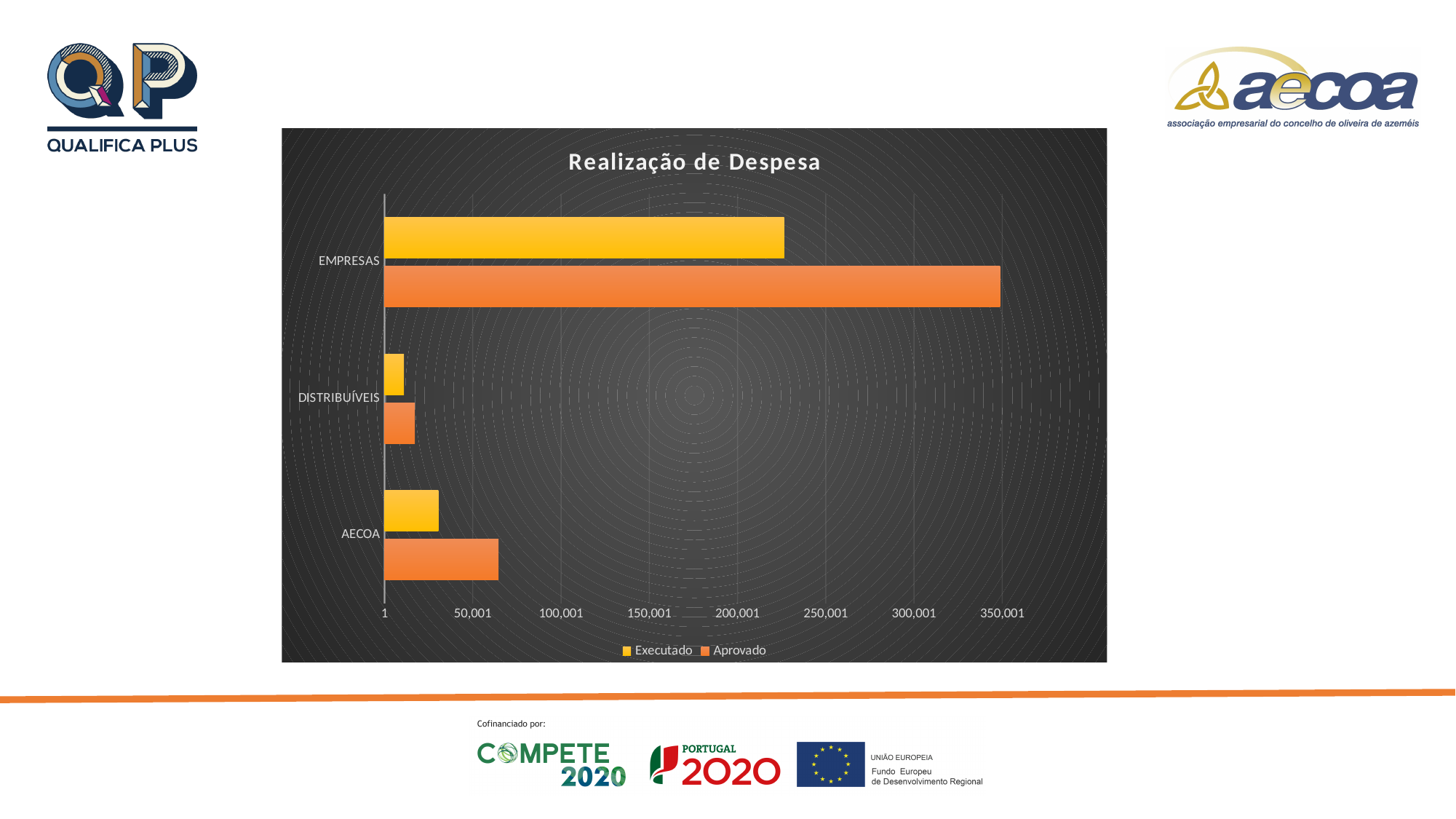
For EMPRESAS, which is larger: Executado or Aprovado? Aprovado How many categories are shown on the chart? 3 Which category has the highest Aprovado value? EMPRESAS Is the Aprovado value for EMPRESAS greater or less than 300,001? greater What type of chart is shown on the slide? bar chart Which category has the lowest Executado value? DISTRIBUÍVEIS Is the Executado value for AECOA greater or less than 50,001? less What is the title of the chart? Realização de Despesa Is the Aprovado value for AECOA greater or less than 50,001? greater How many series does the legend list? 2 For AECOA, which is larger: Executado or Aprovado? Aprovado